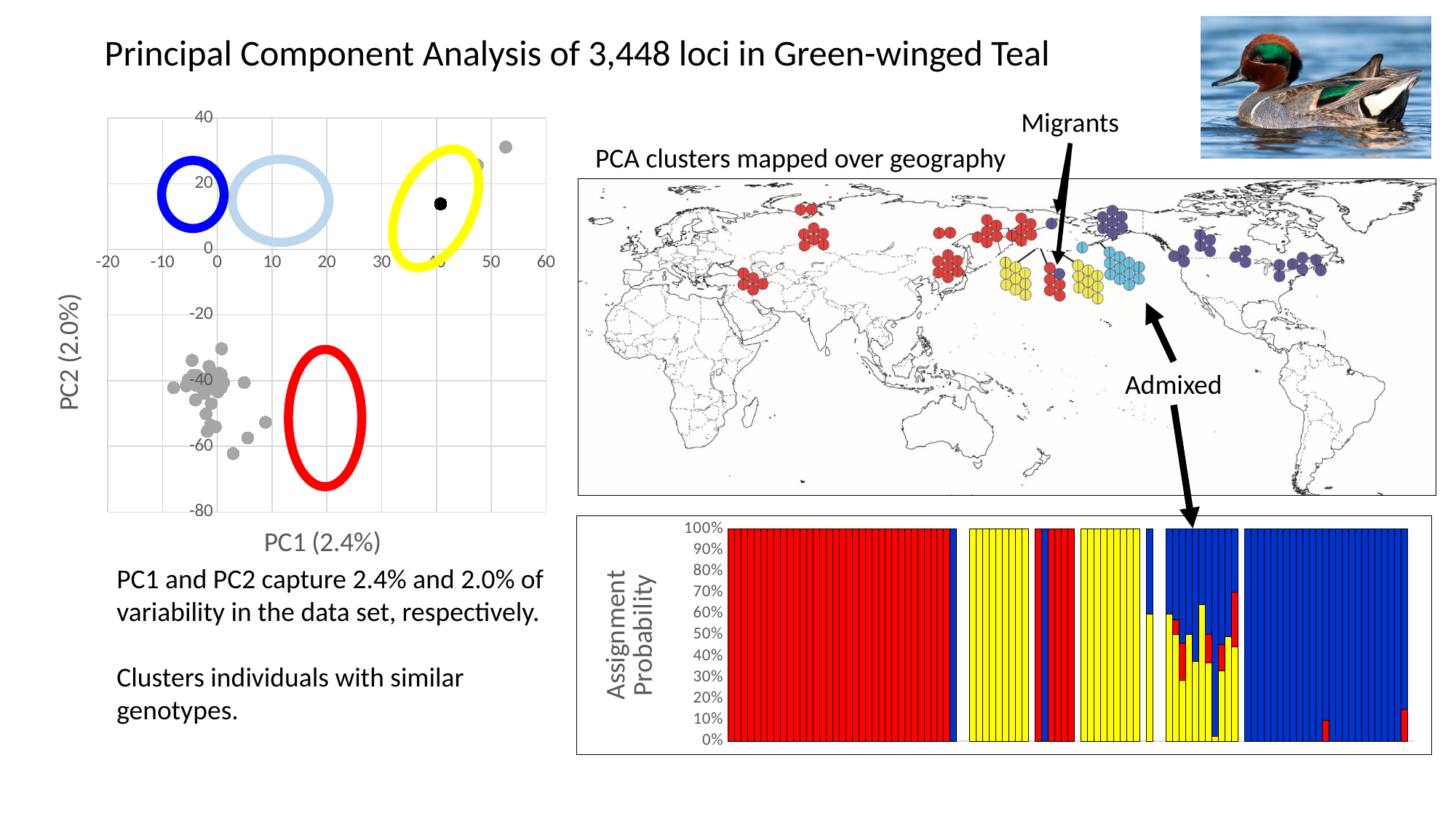
On the left scatter chart, how many coloured ellipses are drawn around clusters? 4 What kind of chart is the chart at the bottom right of the slide showing assignment probability? bar chart On the left scatter chart, what is the lowest tick value shown on the vertical axis? -80 On the left scatter chart, what is the label of the horizontal axis? PC1 (2.4%) On the left scatter chart, is the PC2 value of the black point inside the yellow ellipse greater or less than 0? greater On the left scatter chart, what is the highest tick value shown on the horizontal axis? 60 On the bottom-right assignment probability chart, what is the highest tick value on the vertical axis? 100% On the bottom-right assignment probability chart, how many different colours are used for the stacked bar segments? 3 On the left scatter chart, is the PC2 value of the large cluster of grey points near the bottom left greater or less than -20? less What kind of chart is the chart on the left of the slide with PC1 and PC2 axes? scatter chart On the left scatter chart, what is the label of the vertical axis? PC2 (2.0%)